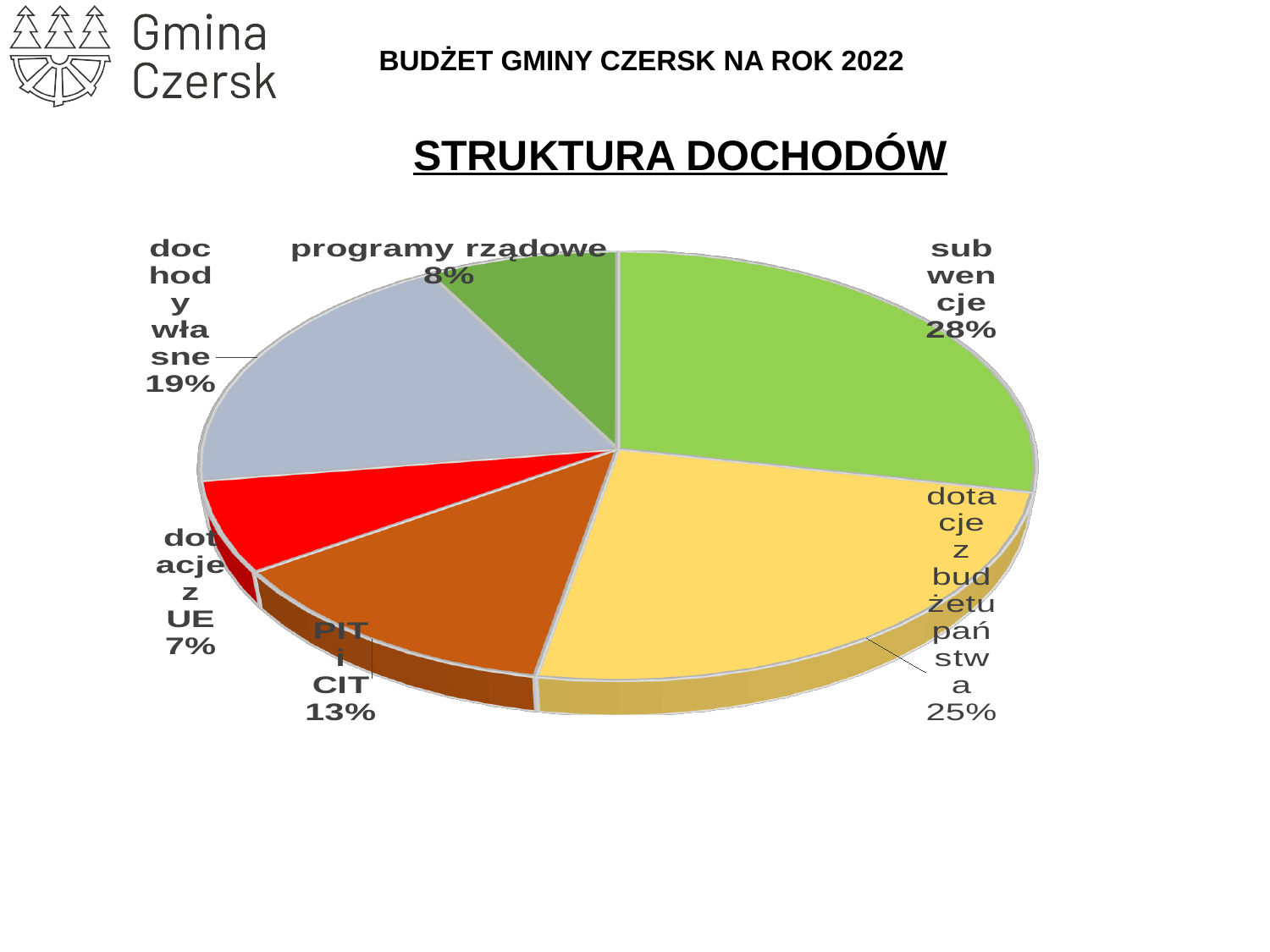
How many slices does the pie chart have? 6 What percentage is shown for 'dotacje z budżetu państwa'? 25% What kind of chart is shown on the slide? pie chart Which category has the smallest share of the pie? dotacje z UE Which is larger, 'dochody własne' or 'PIT i CIT'? dochody własne What is the title of the chart? STRUKTURA DOCHODÓW What percentage does 'programy rządowe' account for? 8% What is the difference in percentage points between 'subwencje' and 'dotacje z budżetu państwa'? 3 What share is labelled for 'dochody własne'? 19% What is the value for 'PIT i CIT'? 13% What share of the pie does 'subwencje' represent? 28% Which category has the largest share of the pie? subwencje